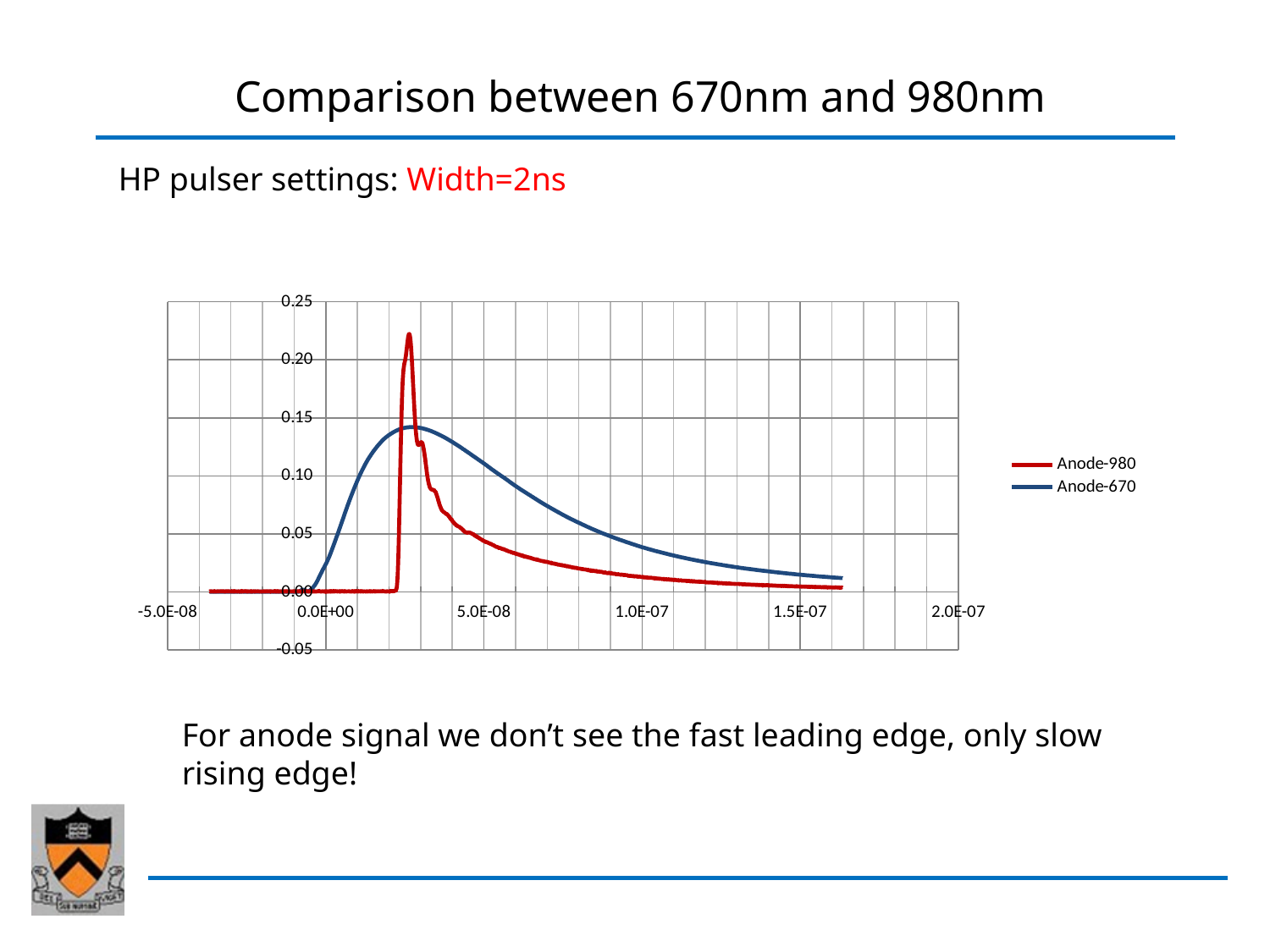
Which series reaches the higher peak value, Anode-980 or Anode-670? Anode-980 At x = 1.0E-07, which series has the larger value, Anode-980 or Anode-670? Anode-670 Is the peak value of the Anode-670 series greater or less than 0.20? less What colour is the Anode-980 line in the chart? red After their peaks, do the values of both series rise or fall as x increases? fall Is the peak value of the Anode-980 series greater or less than 0.20? greater How many series does the chart legend list? 2 What kind of chart is shown on the slide? line chart Is the value of the Anode-980 series at x = 1.0E-07 greater or less than 0.05? less What are the two series named in the chart legend? Anode-980 and Anode-670